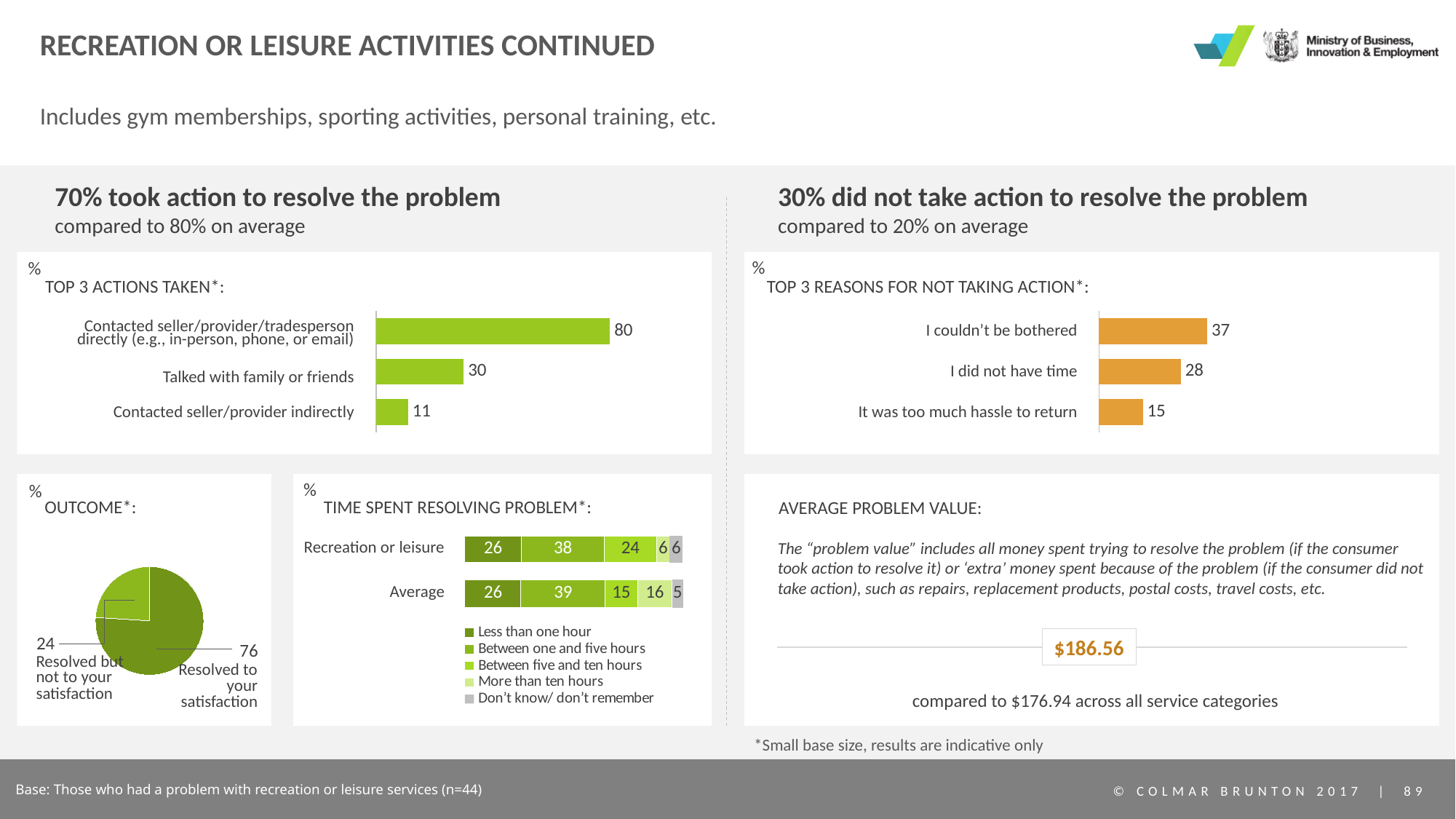
In the 'Time spent resolving problem' chart, what is the value for 'Between five and ten hours' for 'Recreation or leisure'? 24 In the 'Top 3 actions taken' chart, what is the difference between 'Contacted seller/provider/tradesperson directly' and 'Contacted seller/provider indirectly'? 69 In the 'Time spent resolving problem' chart, what is the total of the 'Recreation or leisure' stacked bar? 100 In the 'Top 3 reasons for not taking action' chart, which reason has the lowest value? It was too much hassle to return In the 'Outcome' pie chart, what share is 'Resolved to your satisfaction'? 76 In the 'Time spent resolving problem' chart, which is larger for 'Between one and five hours': 'Recreation or leisure' or 'Average'? Average In the 'Top 3 actions taken' chart, which action has the highest value? Contacted seller/provider/tradesperson directly (e.g., in-person, phone, or email) In the 'Top 3 reasons for not taking action' chart, how many reasons are shown? 3 In the 'Time spent resolving problem' chart, how many series does the legend list? 5 In the 'Top 3 reasons for not taking action' chart, what is the value for 'I did not have time'? 28 In the 'Top 3 actions taken' chart, what is the value for 'Talked with family or friends'? 30 What kind of chart is the 'Outcome' chart? Pie chart